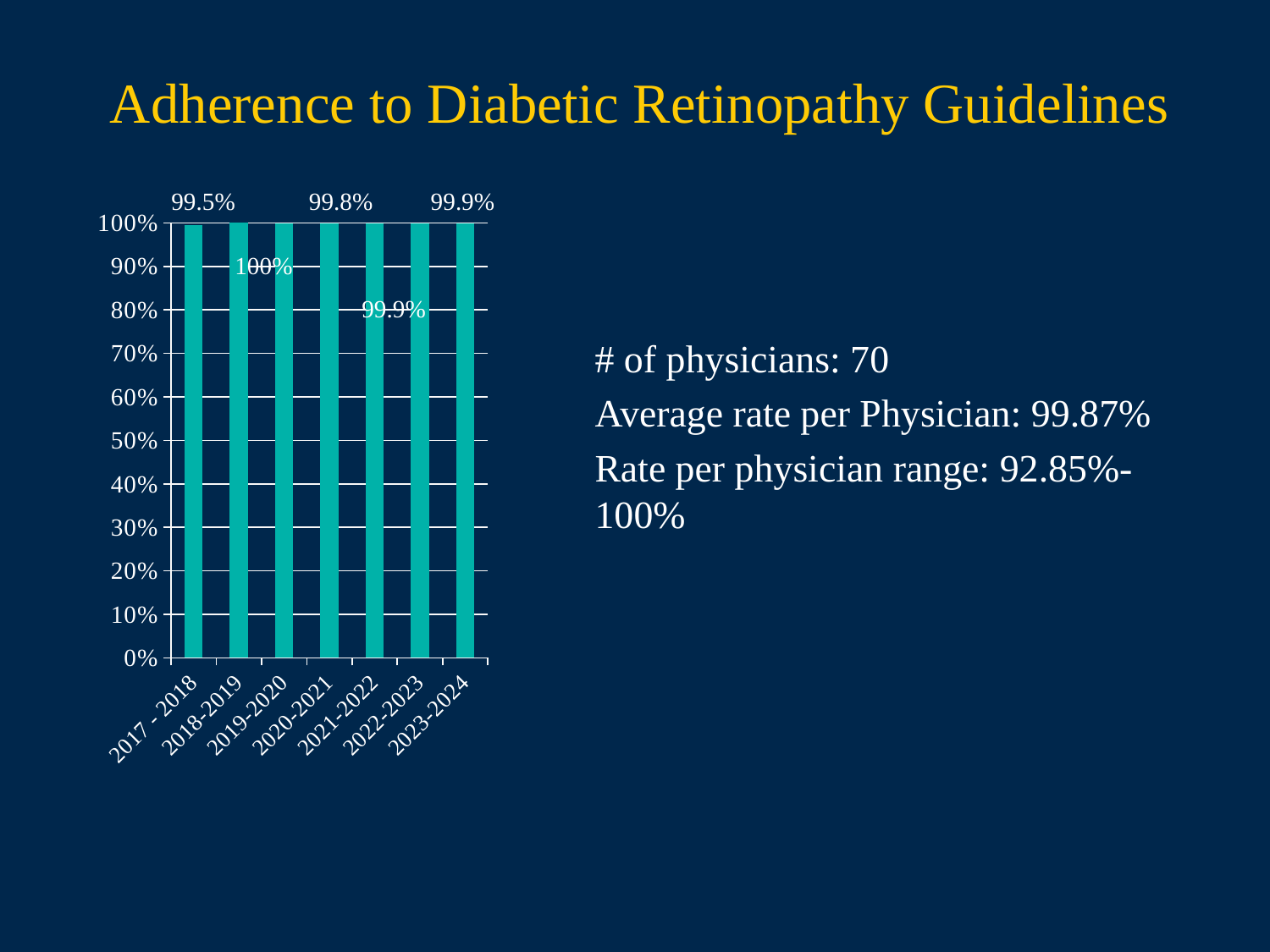
How many year periods (bars) are plotted in the chart? 7 What is the highest tick value shown on the chart's y axis? 100% What kind of chart is shown on the slide? bar chart Is the value for 2019-2020 greater or less than 90%? greater What is the adherence value labelled for 2017 - 2018? 99.5% What is the difference between the labelled values for 2023-2024 and 2017 - 2018? 0.4% What is the title of the slide's chart? Adherence to Diabetic Retinopathy Guidelines Is the value for 2022-2023 greater or less than 50%? greater What is the adherence value labelled for 2023-2024? 99.9% Which has the larger labelled value, 2017 - 2018 or 2023-2024? 2023-2024 What is the first category on the x axis of the chart? 2017 - 2018